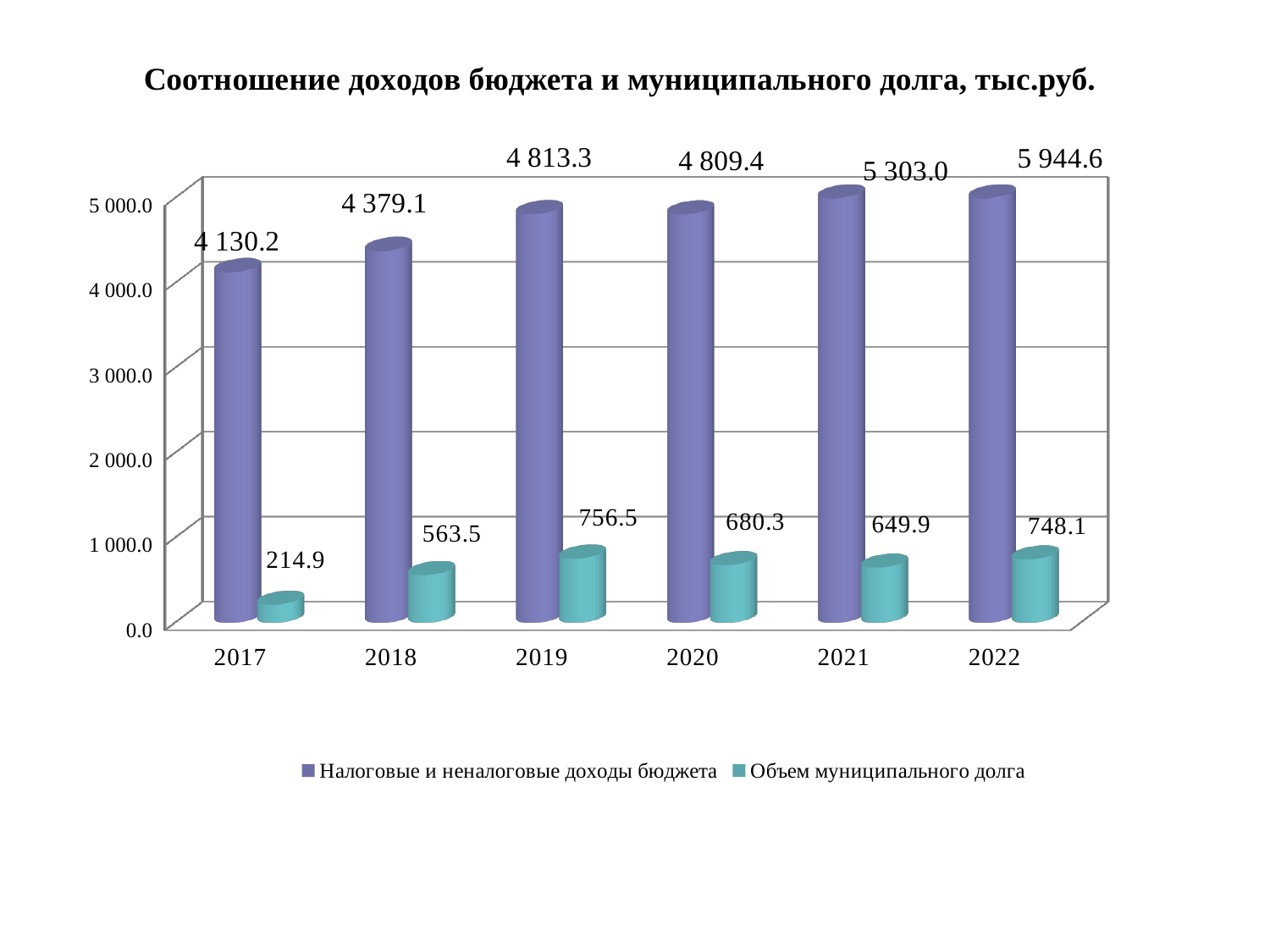
What type of chart is shown on the slide? Bar chart In which year is Объем муниципального долга lowest? 2017 What is the title of the chart? Соотношение доходов бюджета и муниципального долга, тыс.руб. In which year is Налоговые и неналоговые доходы бюджета highest? 2022 How many years are shown on the x axis? 6 Which is larger: Объем муниципального долга in 2019 or in 2020? 2019 How many series does the legend list? 2 Is the value of Налоговые и неналоговые доходы бюджета in 2021 greater or less than 5 000.0? greater What is the value of Налоговые и неналоговые доходы бюджета in 2019? 4 813.3 What is the value of Объем муниципального долга in 2017? 214.9 What is the value of Объем муниципального долга in 2021? 649.9 What is the difference between Налоговые и неналоговые доходы бюджета and Объем муниципального долга in 2022? 5 196.5